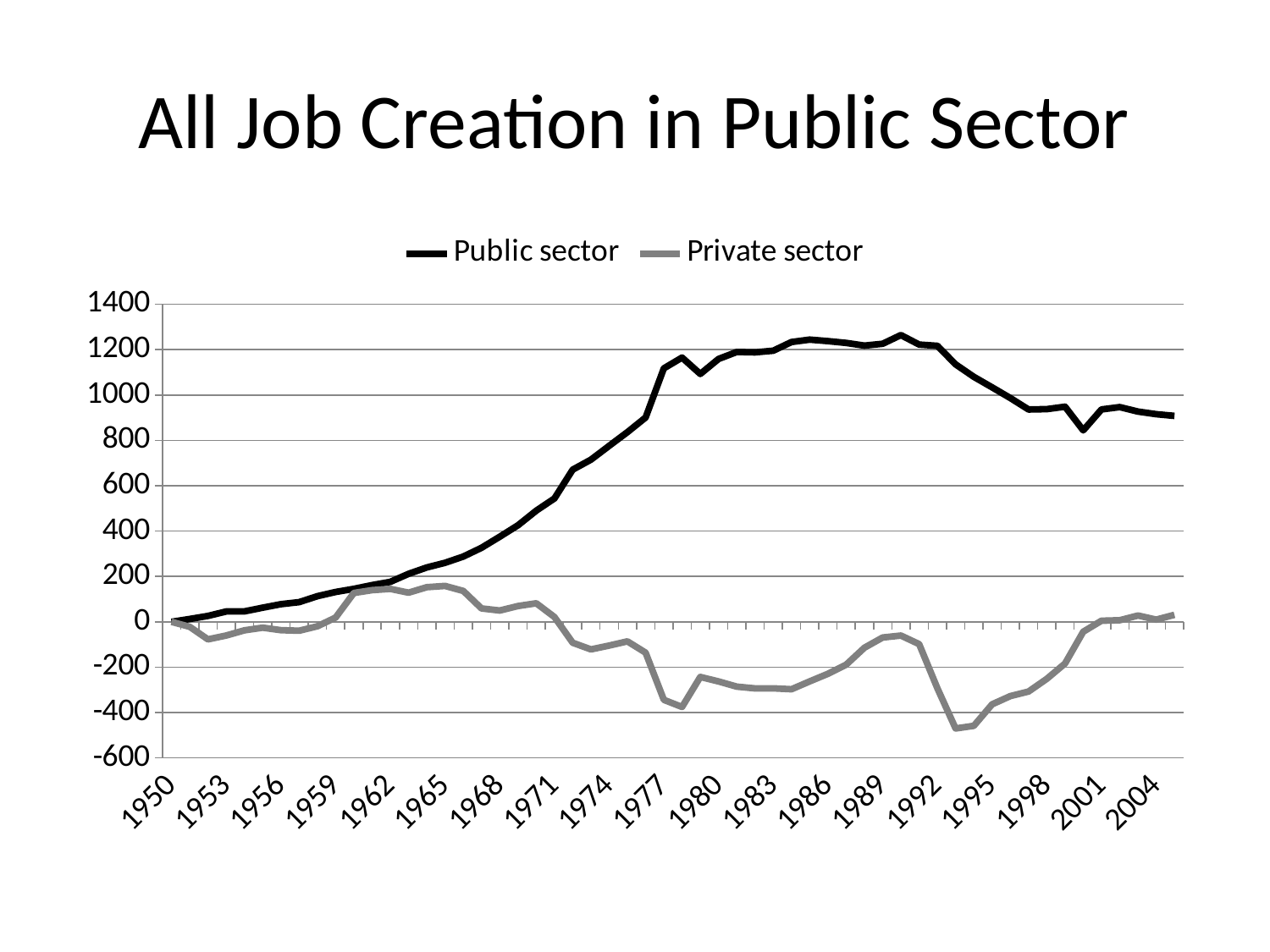
Is the value for Public sector in 1962 greater or less than 400? less Which series reaches the highest value anywhere on the chart? Public sector Is the value for Private sector in 1965 greater or less than 0? greater What are the two series named in the legend? Public sector and Private sector Does the Public sector line rise or fall between 1950 and 1977? rise Does the Public sector line rise or fall between 1989 and 1998? fall How many series does the legend list? 2 In 1980, which series has the higher value, Public sector or Private sector? Public sector What kind of chart is shown on the slide? line chart Is the value for Private sector in 1995 greater or less than -200? less What is the title of the chart? All Job Creation in Public Sector